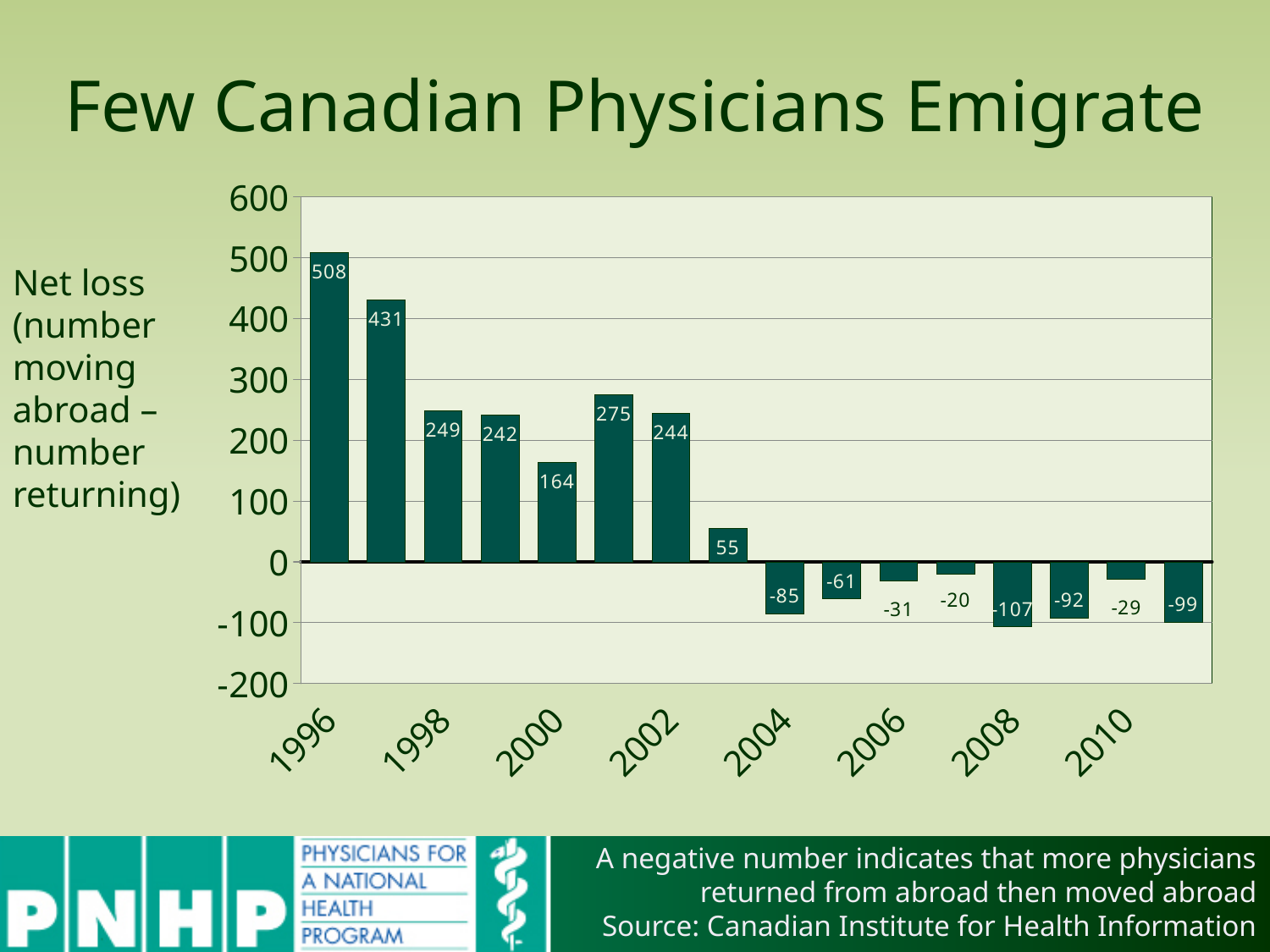
What is the net loss value for 1996? 508 Which year has the highest net loss value? 1996 What is the net loss value for 2008? -107 What is the difference between the net loss values for 1996 and 1998? 259 What is the net loss value for 2010? -29 What is the net loss value for 2004? -85 Which year has the lowest net loss value? 2008 How many bars are plotted in the chart? 16 Which year has the larger net loss value, 2000 or 2002? 2002 What is the net loss value for 2000? 164 What kind of chart is shown on the slide? Bar chart